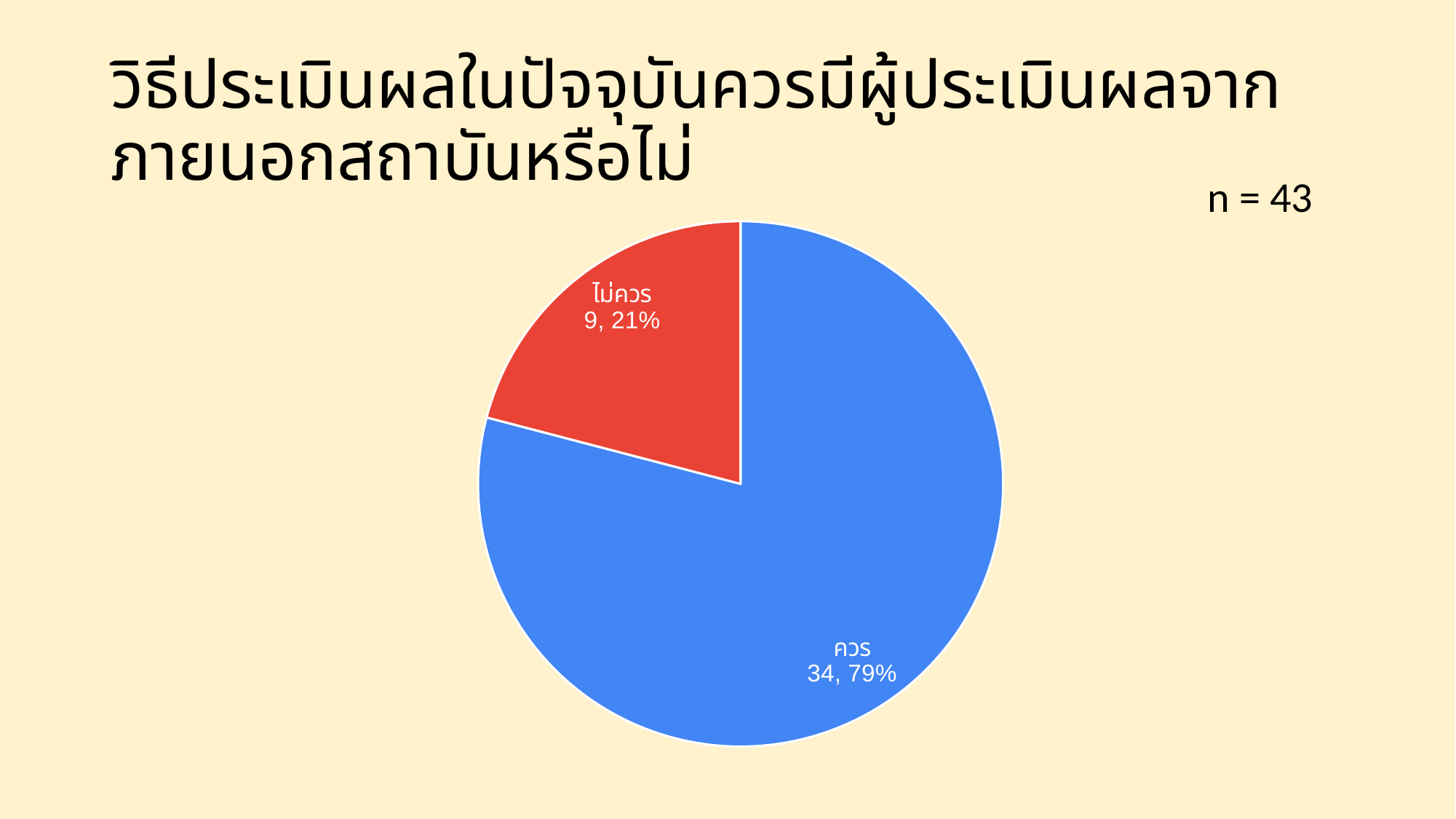
What kind of chart is shown on the slide? pie chart How many slices does the pie chart have? 2 What percentage share does the ควร slice have? 79% What colour is the ไม่ควร slice? red What is the total number of responses (n) shown on the slide? 43 Which slice is the smallest? ไม่ควร What is the count for the ควร slice? 34 Which is larger, ควร or ไม่ควร? ควร What is the difference in count between ควร and ไม่ควร? 25 Which slice is the largest? ควร What is the count for the ไม่ควร slice? 9 What percentage share does the ไม่ควร slice have? 21%